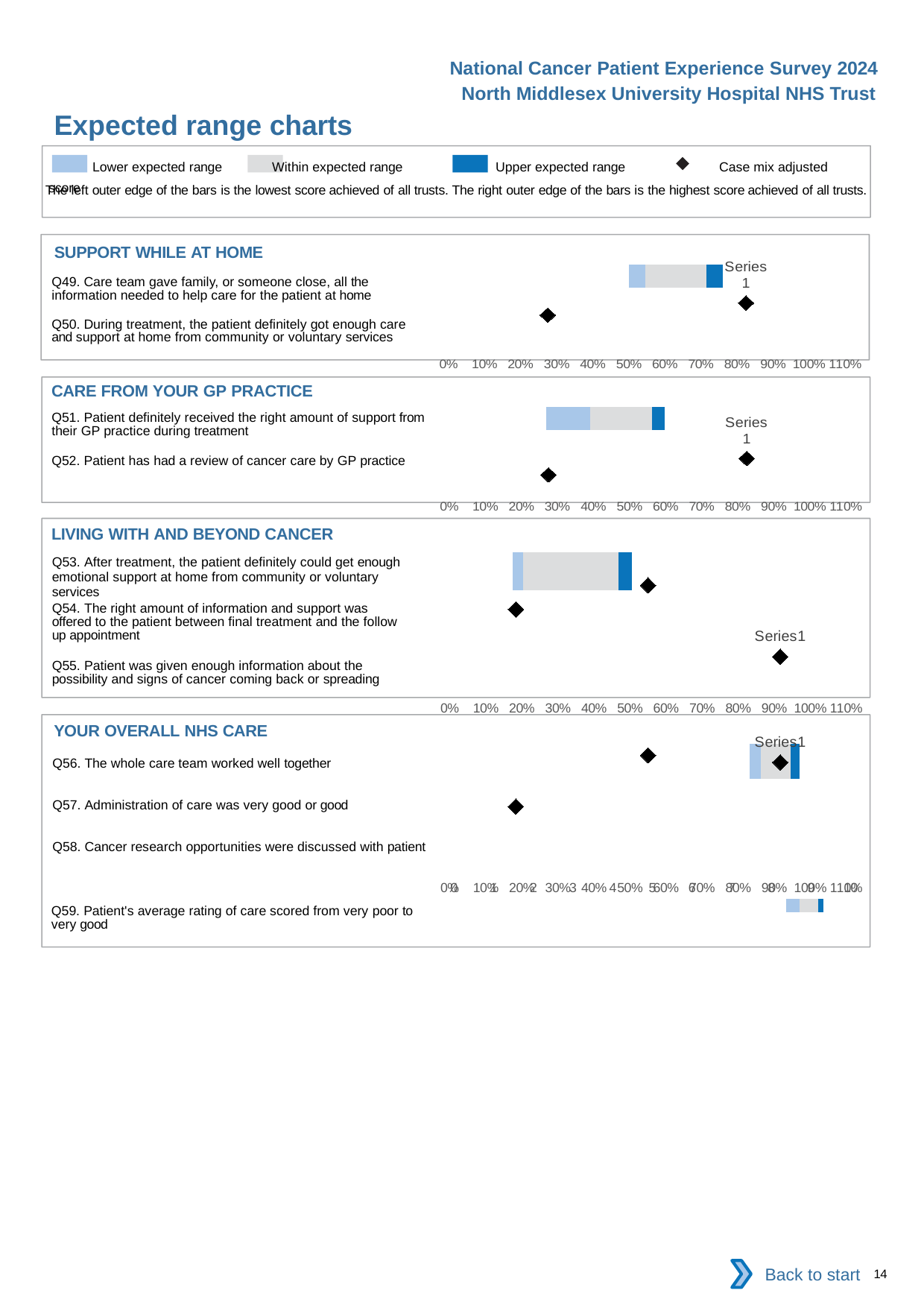
How many questions are plotted in the LIVING WITH AND BEYOND CANCER chart? 3 What is the highest tick label shown on the x axis of the SUPPORT WHILE AT HOME chart? 110% In the SUPPORT WHILE AT HOME chart, is the leftmost diamond marker greater or less than 40%? less According to the legend, what does the black diamond marker represent? Case mix adjusted score How many questions are plotted in the SUPPORT WHILE AT HOME chart? 2 In the LIVING WITH AND BEYOND CANCER chart, is the rightmost diamond marker greater or less than 80%? greater How many questions are plotted in the CARE FROM YOUR GP PRACTICE chart? 2 In the CARE FROM YOUR GP PRACTICE chart, is the leftmost diamond marker greater or less than 50%? less What kind of chart is used in the expected range charts on this slide? bar chart How many entries does the legend at the top of the slide list? 4